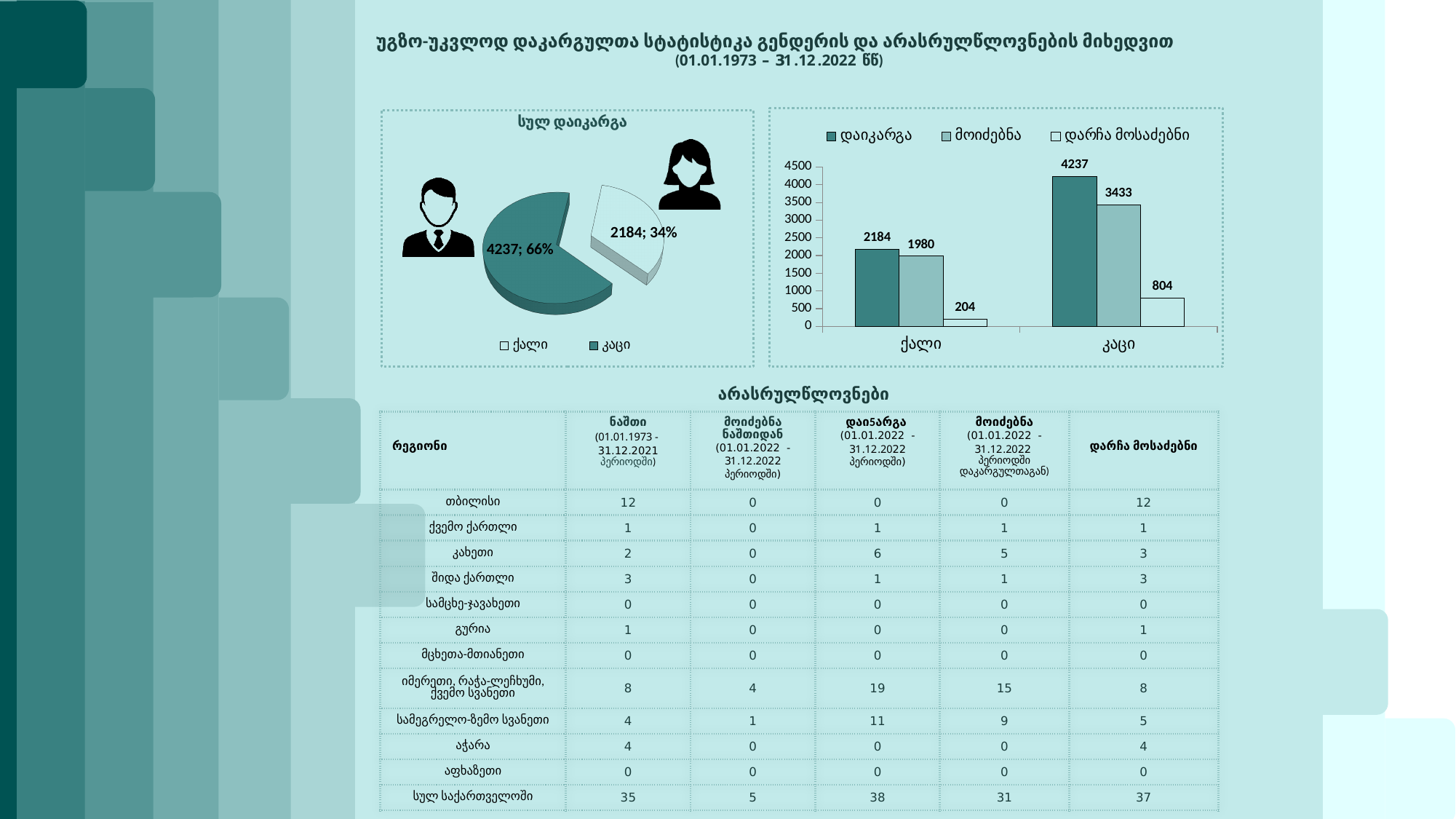
What kind of chart is the chart on the left titled "სულ დაიკარგა"? pie chart In the bar chart on the right, what is the value of დაიკარგა for კაცი? 4237 In the pie chart titled "სულ დაიკარგა", what share of the pie does the ქალი slice represent? 34% In the bar chart on the right, what is the value of დარჩა მოსაძებნი for ქალი? 204 In the bar chart on the right, which bar is the lowest? დარჩა მოსაძებნი for ქალი (204) In the pie chart titled "სულ დაიკარგა", what value and share are shown for the კაცი slice? 4237; 66% In the pie chart titled "სულ დაიკარგა", which slice is larger, ქალი or კაცი? კაცი In the bar chart on the right, what is the value of მოიძებნა for კაცი? 3433 In the bar chart on the right, what is the difference between დაიკარგა and მოიძებნა for ქალი? 204 In the bar chart on the right, is the value of მოიძებნა for ქალი greater or less than 2000? less What kind of chart is the chart on the right of the slide? bar chart In the bar chart on the right, how many series does the legend list? 3